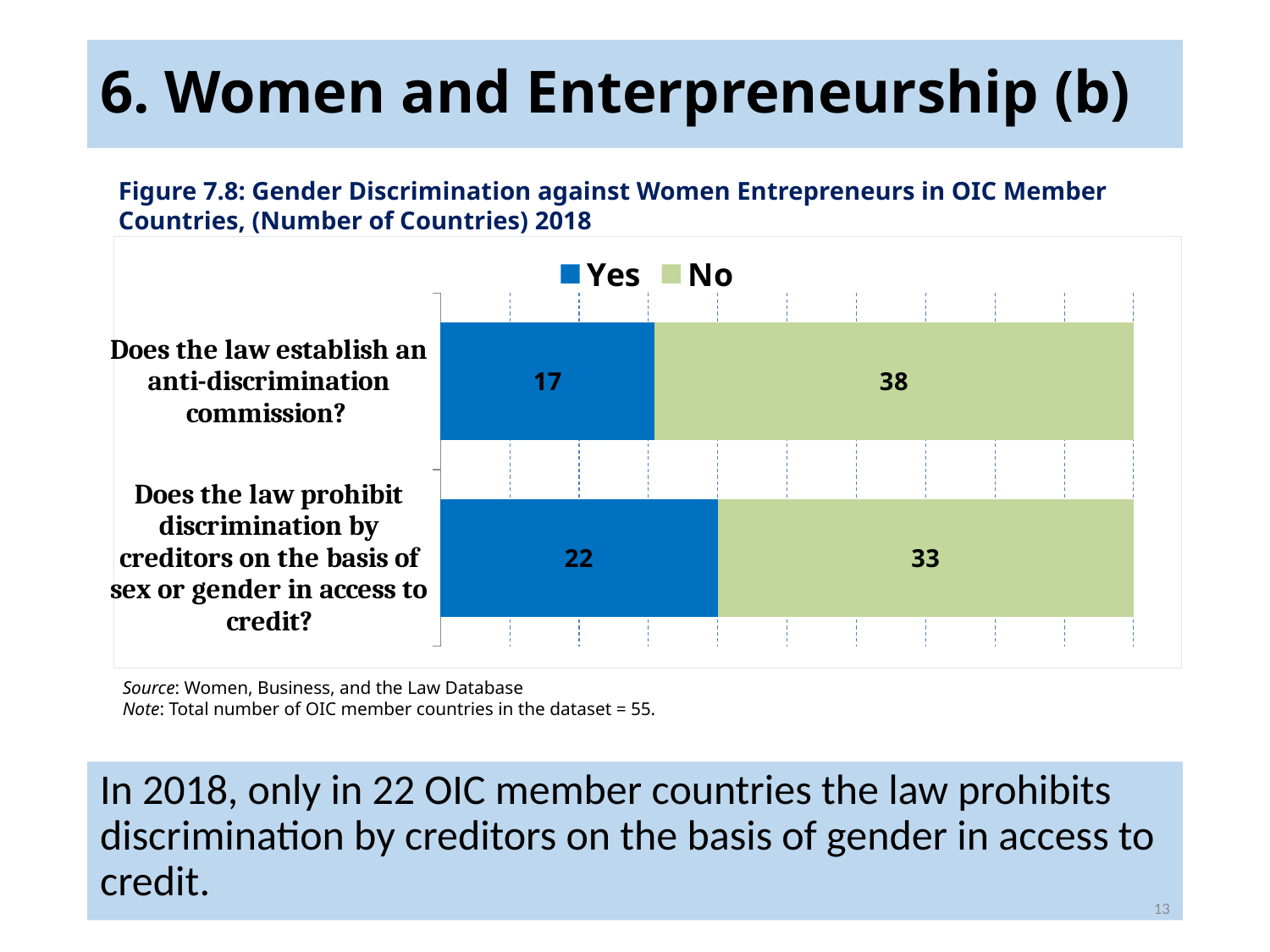
Which question has the larger "Yes" count: the anti-discrimination commission question or the creditor discrimination question? Does the law prohibit discrimination by creditors on the basis of sex or gender in access to credit? How many countries answered "No" to whether the law prohibits discrimination by creditors on the basis of sex or gender in access to credit? 33 What is the total number of countries in the bar for "Does the law prohibit discrimination by creditors on the basis of sex or gender in access to credit?" 55 How many series does the legend list? 2 How many countries answered "No" to whether the law establishes an anti-discrimination commission? 38 How many countries answered "Yes" to whether the law prohibits discrimination by creditors on the basis of sex or gender in access to credit? 22 What kind of chart is shown on the slide? Stacked horizontal bar chart What is the total number of countries in the bar for "Does the law establish an anti-discrimination commission?" 55 What is the difference between the "No" and "Yes" counts for the anti-discrimination commission question? 21 How many categories (questions) are shown on the chart? 2 What is the difference between the "No" and "Yes" counts for the creditor discrimination question? 11 How many countries answered "Yes" to whether the law establishes an anti-discrimination commission? 17